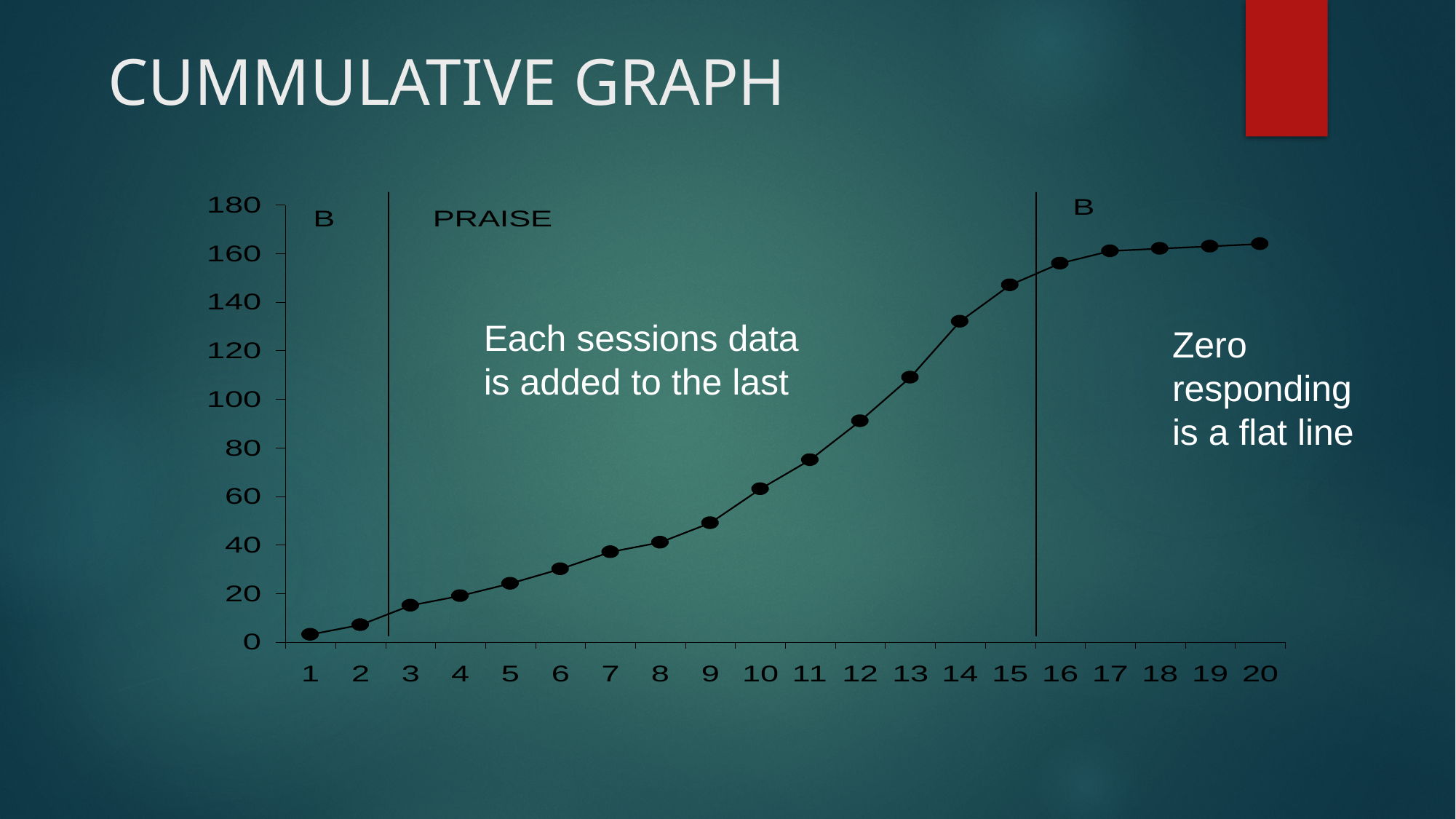
Is the value for session 14 greater or less than 120? greater What kind of chart is shown on the slide? line chart Which session has the lowest plotted value? 1 What is the title of the slide containing the chart? CUMMULATIVE GRAPH Is the value for session 12 greater or less than 100? less How many sessions (data points) are plotted on the x axis? 20 Which has the larger value, session 5 or session 15? session 15 Is the value for session 5 greater or less than 40? less What label is written on the chart for the middle phase between the two vertical lines? PRAISE Which session has the highest plotted value? 20 Do the plotted values rise or fall as the session number increases? rise